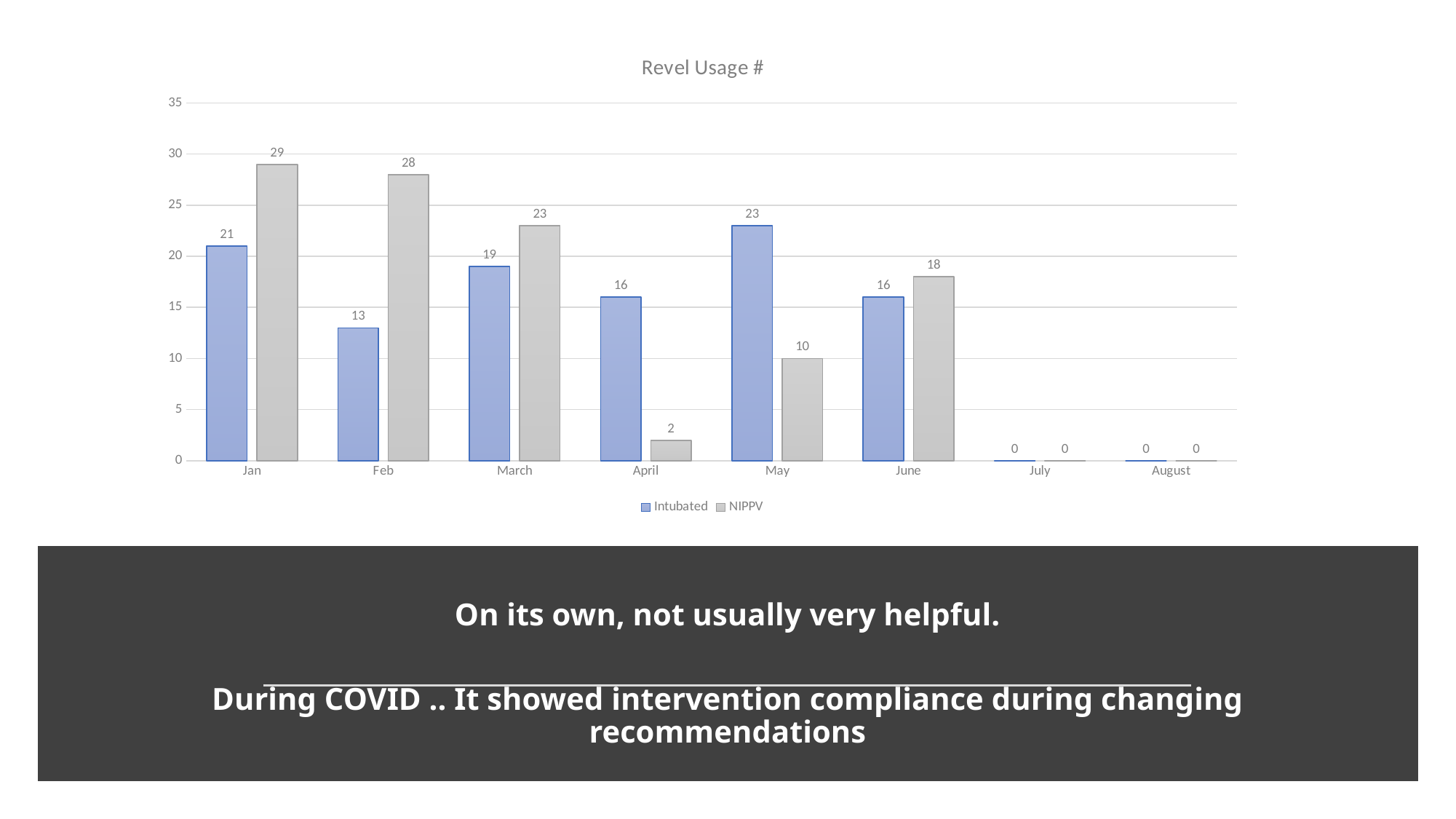
What is the total of the Intubated and NIPPV values for June? 34 What is the difference between the NIPPV and Intubated values for Jan? 8 How many months are shown on the x axis? 8 How many series does the legend list? 2 What is the NIPPV value for Feb? 28 Which month has the lowest Intubated value among Jan through June? Feb In May, which is larger, Intubated or NIPPV? Intubated What is the title of the chart? Revel Usage # What is the NIPPV value for April? 2 Which month has the highest NIPPV value? Jan What is the Intubated value for Jan? 21 What kind of chart is this? Bar chart